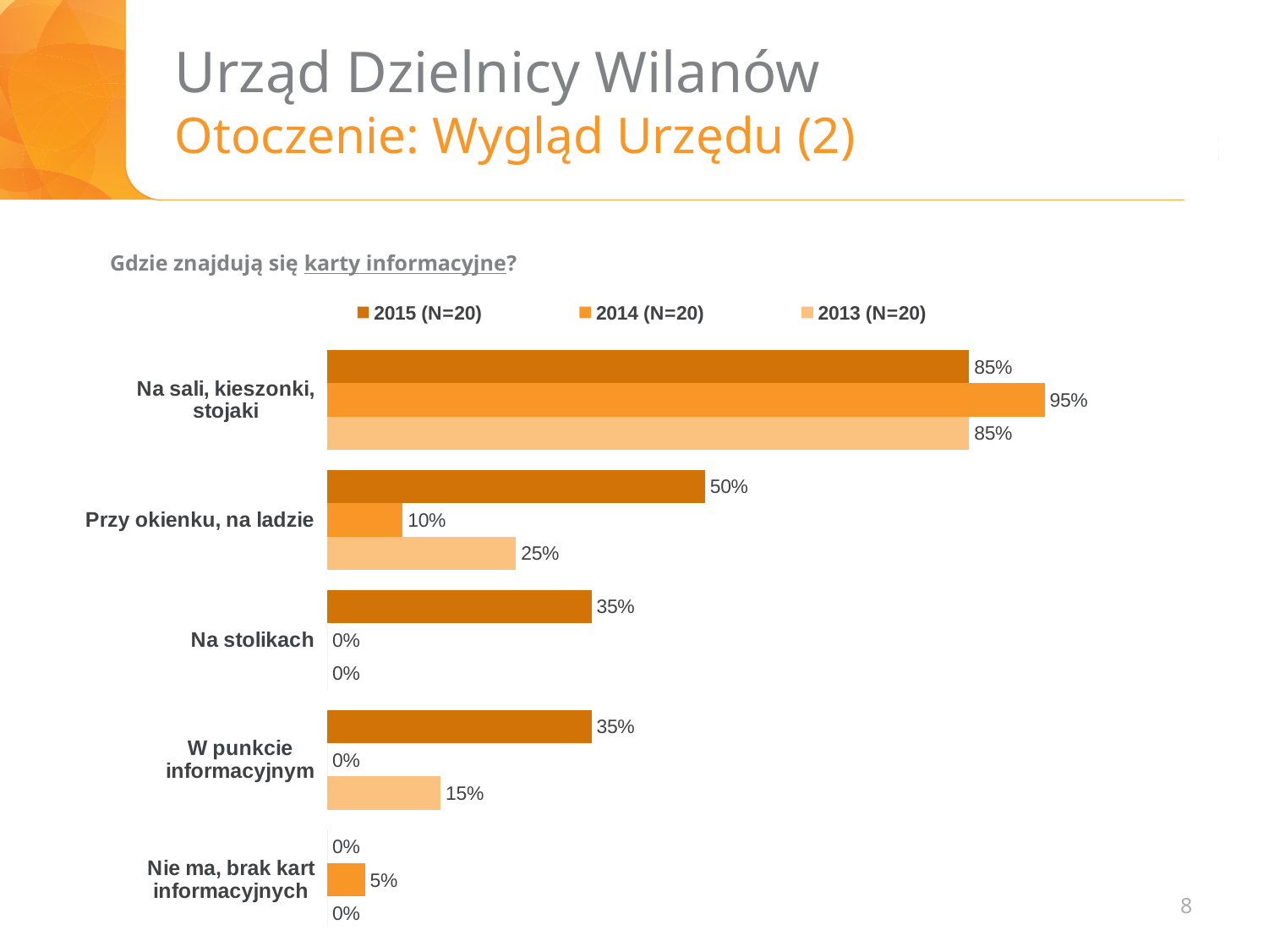
How many series does the legend list? 3 Which category has the highest value in the 2015 (N=20) series? Na sali, kieszonki, stojaki What question does the chart answer, as stated above it? Gdzie znajdują się karty informacyjne? What is the value for "Na sali, kieszonki, stojaki" in the 2014 (N=20) series? 95% What is the value for "Przy okienku, na ladzie" in the 2015 (N=20) series? 50% What is the value for "W punkcie informacyjnym" in the 2013 (N=20) series? 15% Which category has the lowest value in the 2015 (N=20) series? Nie ma, brak kart informacyjnych How many categories are shown on the chart? 5 What is the value for "Nie ma, brak kart informacyjnych" in the 2014 (N=20) series? 5% What is the difference between the 2015 (N=20) and 2014 (N=20) values for "Przy okienku, na ladzie"? 40% What kind of chart is shown on the slide? Bar chart Which is larger for "Na stolikach": the 2015 (N=20) value or the 2013 (N=20) value? 2015 (N=20)